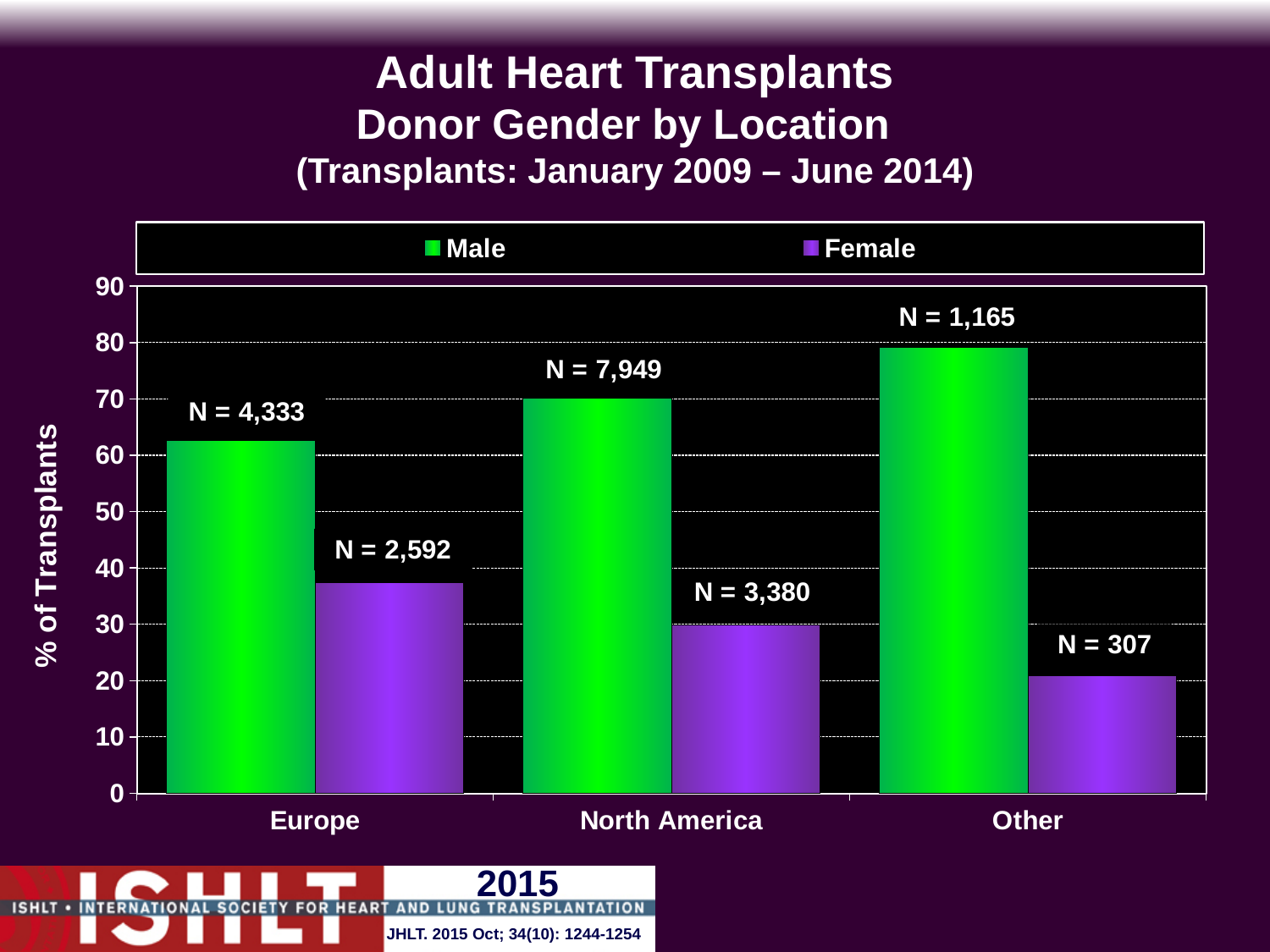
Which location has the tallest Male bar? Other Is the Male bar for Other greater or less than 70? greater What is the N value shown above the Male bar for North America? N = 7,949 Which is larger for Europe, the Male bar or the Female bar? Male What is the N value shown above the Female bar for North America? N = 3,380 How many series does the legend list? 2 Is the Male bar for Europe greater or less than 60? greater What kind of chart is shown on the slide? Bar chart What is the N value shown above the Female bar for Other? N = 307 What is the N value shown above the Male bar for Europe? N = 4,333 Is the Female bar for North America greater or less than 40? less Which location has the shortest Female bar? Other